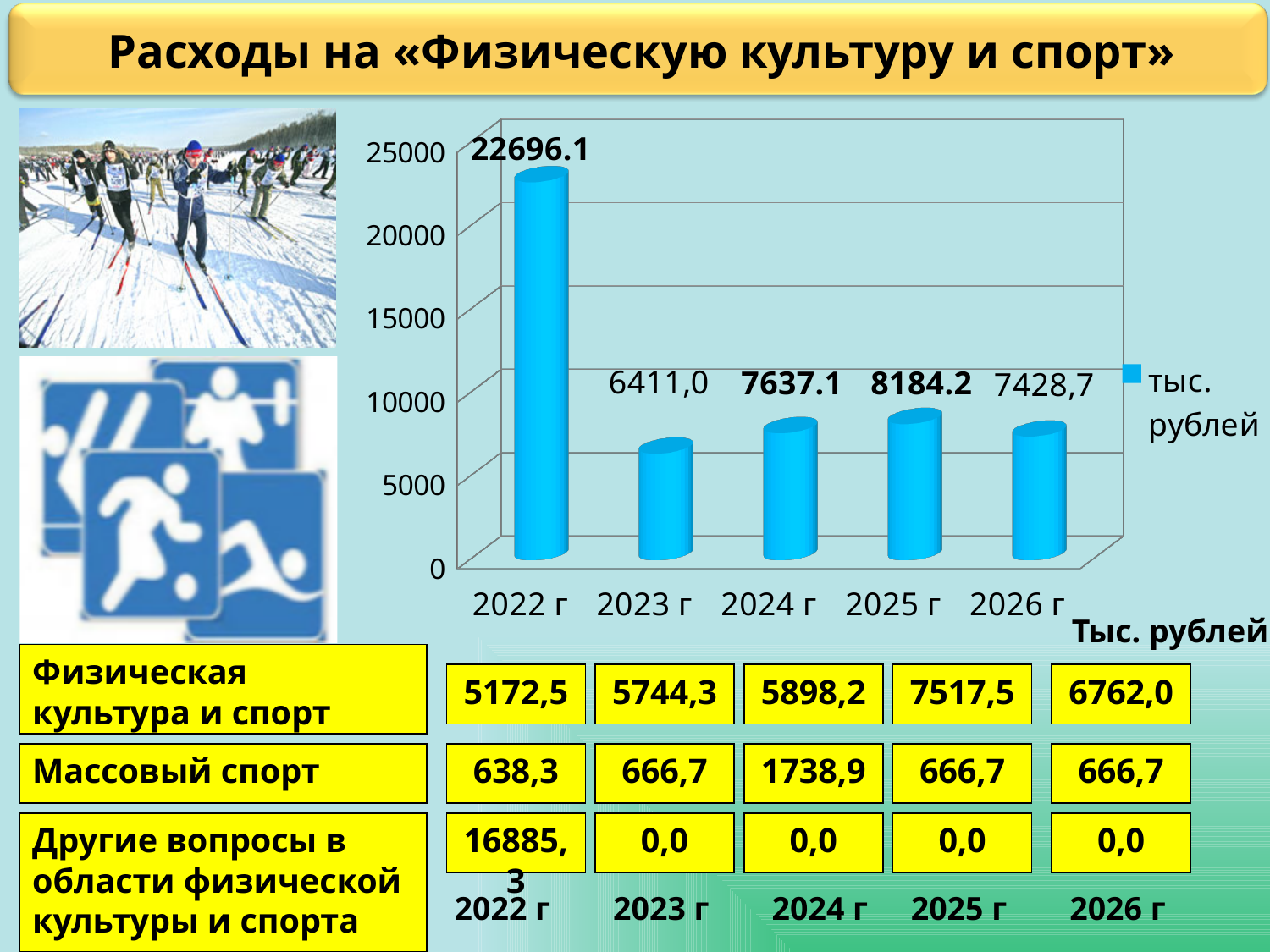
Is the value for 2023 г greater or less than 10000? less What is the difference between the values for 2025 г and 2024 г? 547.1 Which is larger, the value for 2024 г or the value for 2026 г? 2024 г What is the value for 2022 г on the chart? 22696.1 Which year has the lowest value on the chart? 2023 г What is the value for 2023 г on the chart? 6411,0 What is the value for 2025 г on the chart? 8184.2 What unit does the chart legend give for the values? тыс. рублей How many years are shown on the x axis of the chart? 5 Which year has the highest value on the chart? 2022 г What is the value for 2026 г on the chart? 7428,7 What kind of chart is shown on the slide? bar chart